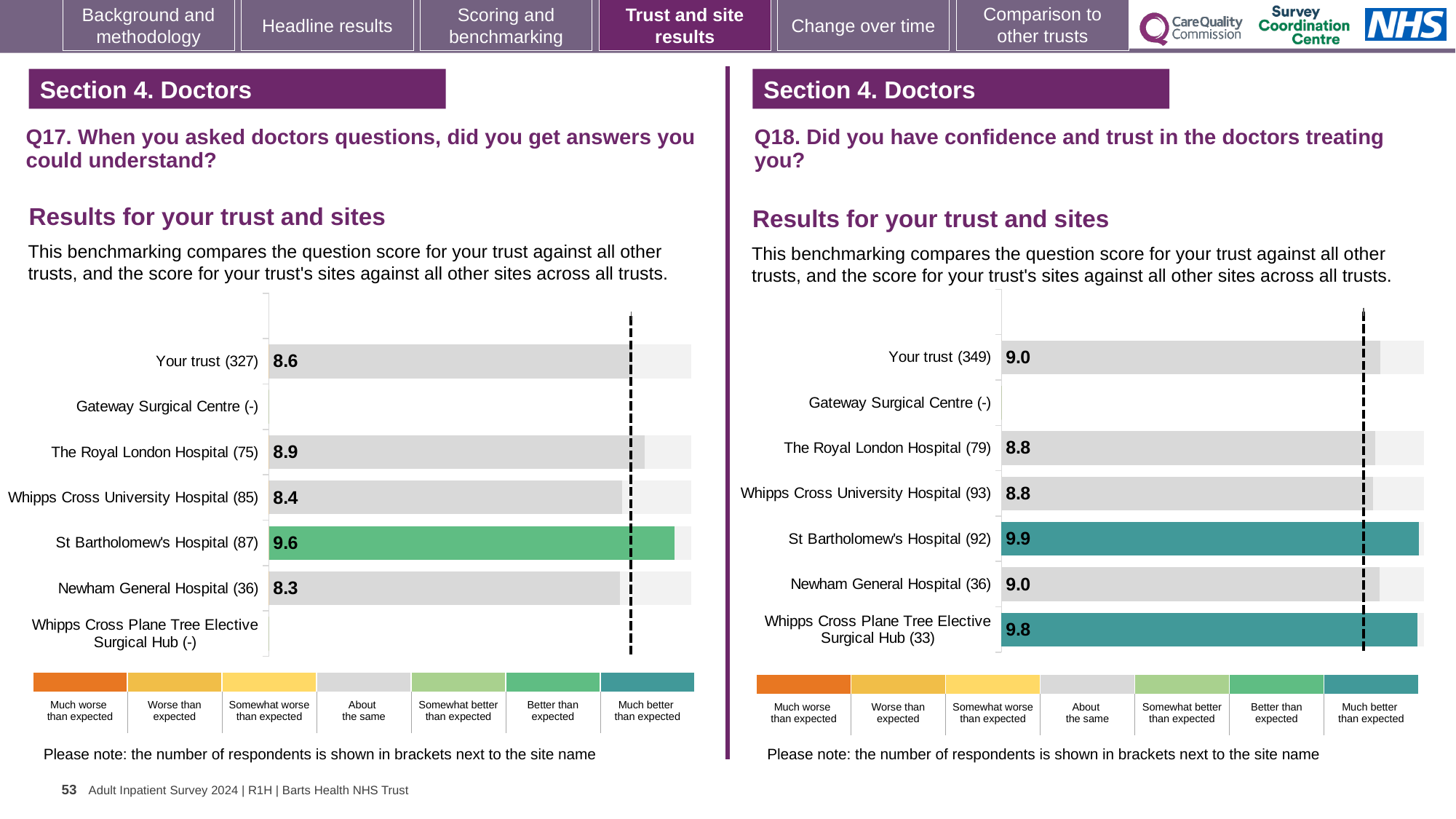
On the Q18 chart, what is the score for Newham General Hospital (36)? 9.0 On the Q17 chart, which site has the highest score? St Bartholomew's Hospital (87) On the Q17 chart, how many site or trust labels are listed on the vertical axis? 7 On the Q17 chart, what is the difference between the scores for St Bartholomew's Hospital and Whipps Cross University Hospital? 1.2 On the Q17 chart, which has the higher score: The Royal London Hospital or Newham General Hospital? The Royal London Hospital On the Q18 chart, how many sites are shaded in the 'Much better than expected' colour? 2 On the Q17 chart, which site has the lowest score among those with a bar? Newham General Hospital (36) On the Q18 chart, what is the difference between the scores for St Bartholomew's Hospital and The Royal London Hospital? 1.1 On the Q17 chart, what is the score for Your trust (327)? 8.6 On the Q18 chart, which site has the highest score? St Bartholomew's Hospital (92) On the Q18 chart, what is the score for Whipps Cross Plane Tree Elective Surgical Hub (33)? 9.8 What type of chart is used on the Q18 chart? Bar chart